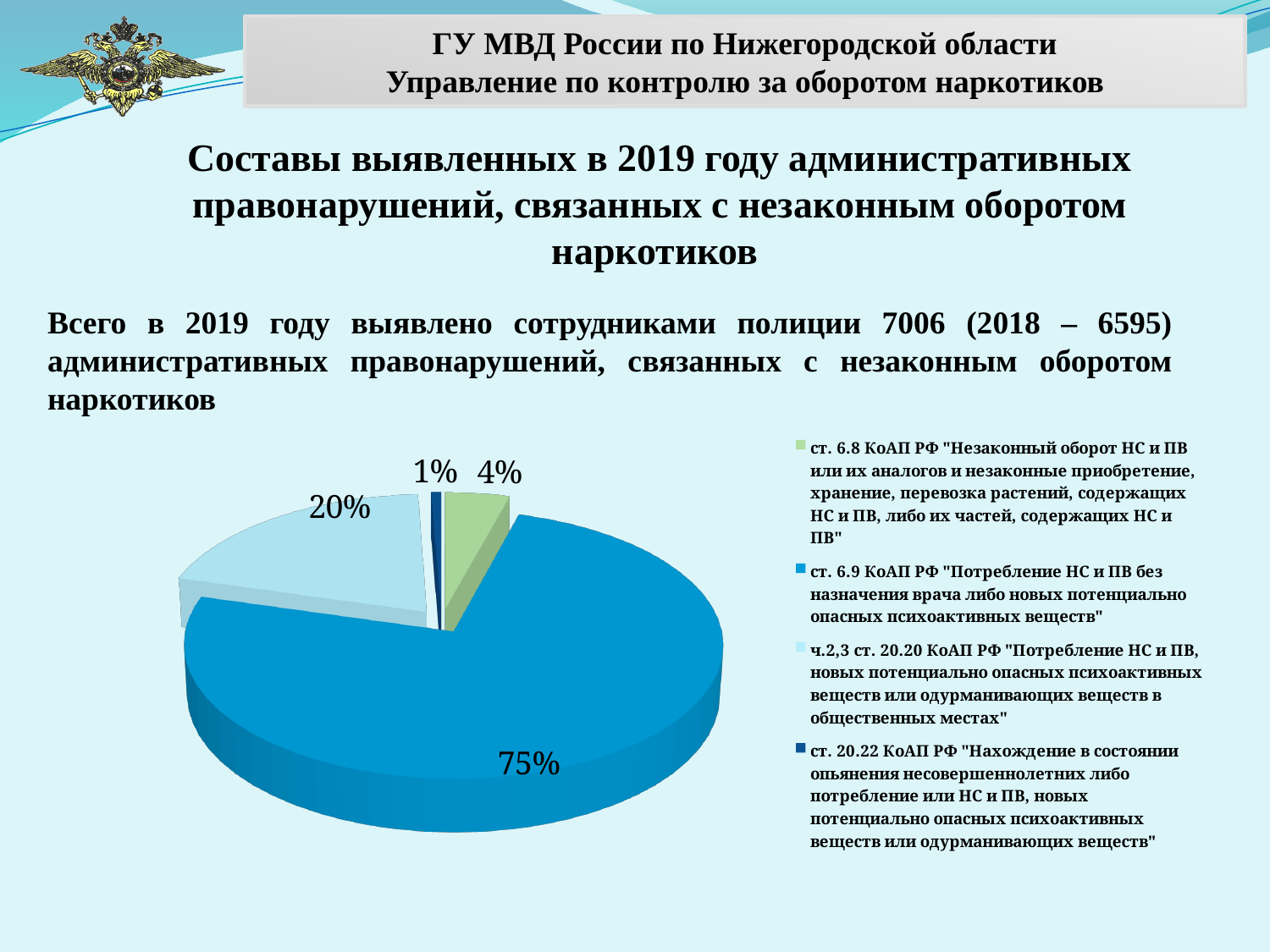
Which legend category has the smallest slice of the pie? ст. 20.22 КоАП РФ "Нахождение в состоянии опьянения несовершеннолетних..." How many slices does the pie chart have? 4 How many entries does the legend of the pie chart list? 4 What share of the pie does ст. 6.9 КоАП РФ (Потребление НС и ПВ без назначения врача) account for? 75% What share of the pie does ч.2,3 ст. 20.20 КоАП РФ account for? 20% What share of the pie does ст. 6.8 КоАП РФ account for? 4% What is the difference in percentage points between the slice for ст. 6.9 КоАП РФ and the slice for ч.2,3 ст. 20.20 КоАП РФ? 55 percentage points What colour is the slice representing ст. 6.8 КоАП РФ in the pie chart? Green Which slice is larger: ст. 6.8 КоАП РФ or ч.2,3 ст. 20.20 КоАП РФ? ч.2,3 ст. 20.20 КоАП РФ What kind of chart is shown on the slide? Pie chart Which legend category has the largest slice of the pie? ст. 6.9 КоАП РФ "Потребление НС и ПВ без назначения врача либо новых потенциально опасных психоактивных веществ"